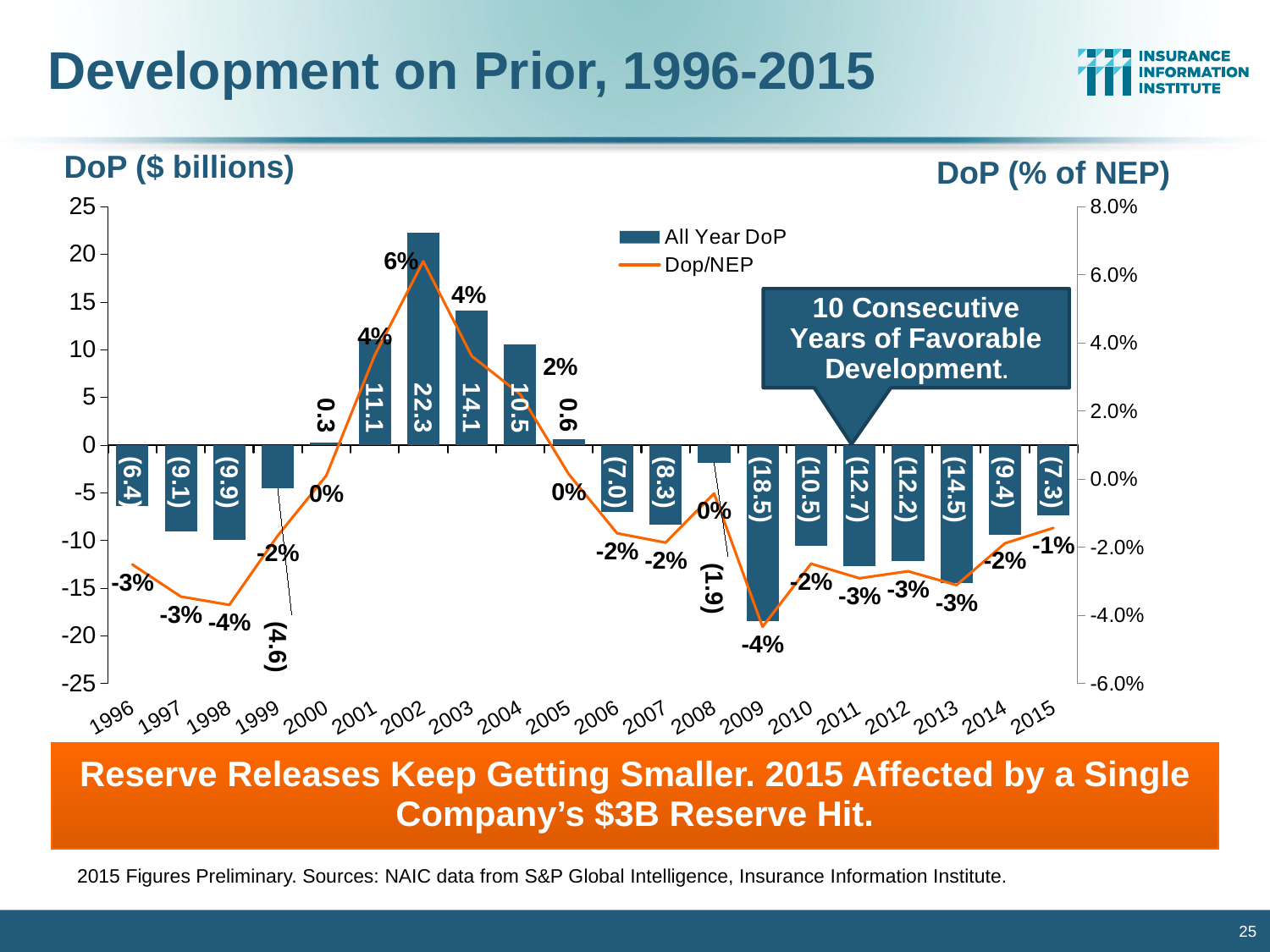
How many years are shown on the x axis? 20 What is the All Year DoP value for 2002? 22.3 Which year has the lowest (most negative) All Year DoP bar? 2009 Which year has the larger All Year DoP value, 2001 or 2004? 2001 How many series does the legend list? 2 What is the Dop/NEP value for 2002? 6% Which year has the highest All Year DoP bar? 2002 What does the callout box on the chart say? 10 Consecutive Years of Favorable Development. What is the All Year DoP value shown for 2009? (18.5) What is the difference between the All Year DoP values for 2002 and 2003? 8.2 What is the Dop/NEP value for 2015? -1% What kind of chart is this? Combined bar and line chart